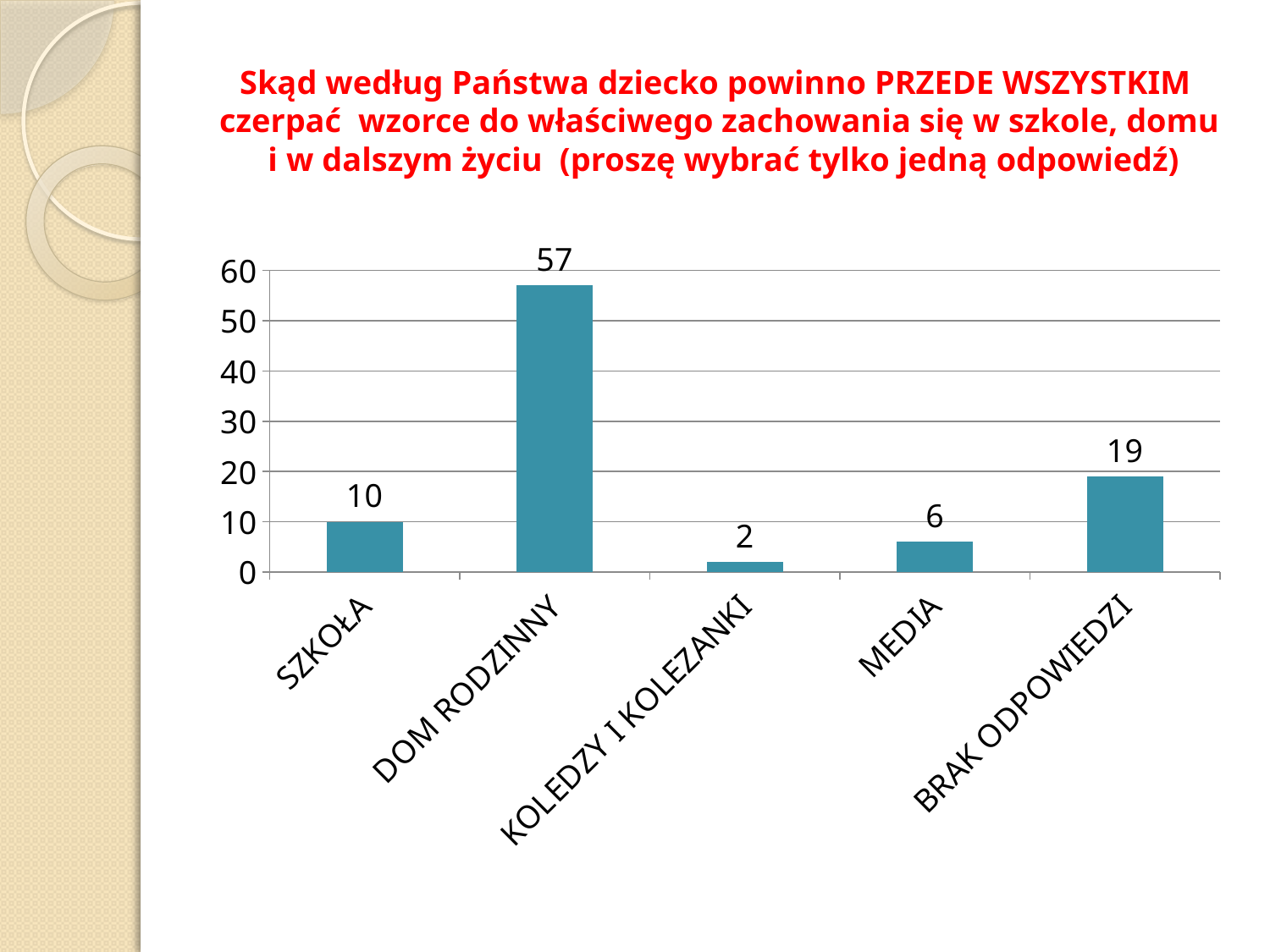
What is the difference between the values for DOM RODZINNY and BRAK ODPOWIEDZI? 38 What is the value for BRAK ODPOWIEDZI? 19 What is the value for MEDIA? 6 What is the highest value shown on the vertical axis? 60 How many categories are shown on the x axis? 5 Is the value for BRAK ODPOWIEDZI greater or less than 10? greater Which category has the lowest value? KOLEDZY I KOLEZANKI What is the value for SZKOŁA? 10 What is the value for DOM RODZINNY? 57 Which is larger, the value for SZKOŁA or the value for MEDIA? SZKOŁA Which category has the highest value? DOM RODZINNY What kind of chart is shown on the slide? bar chart